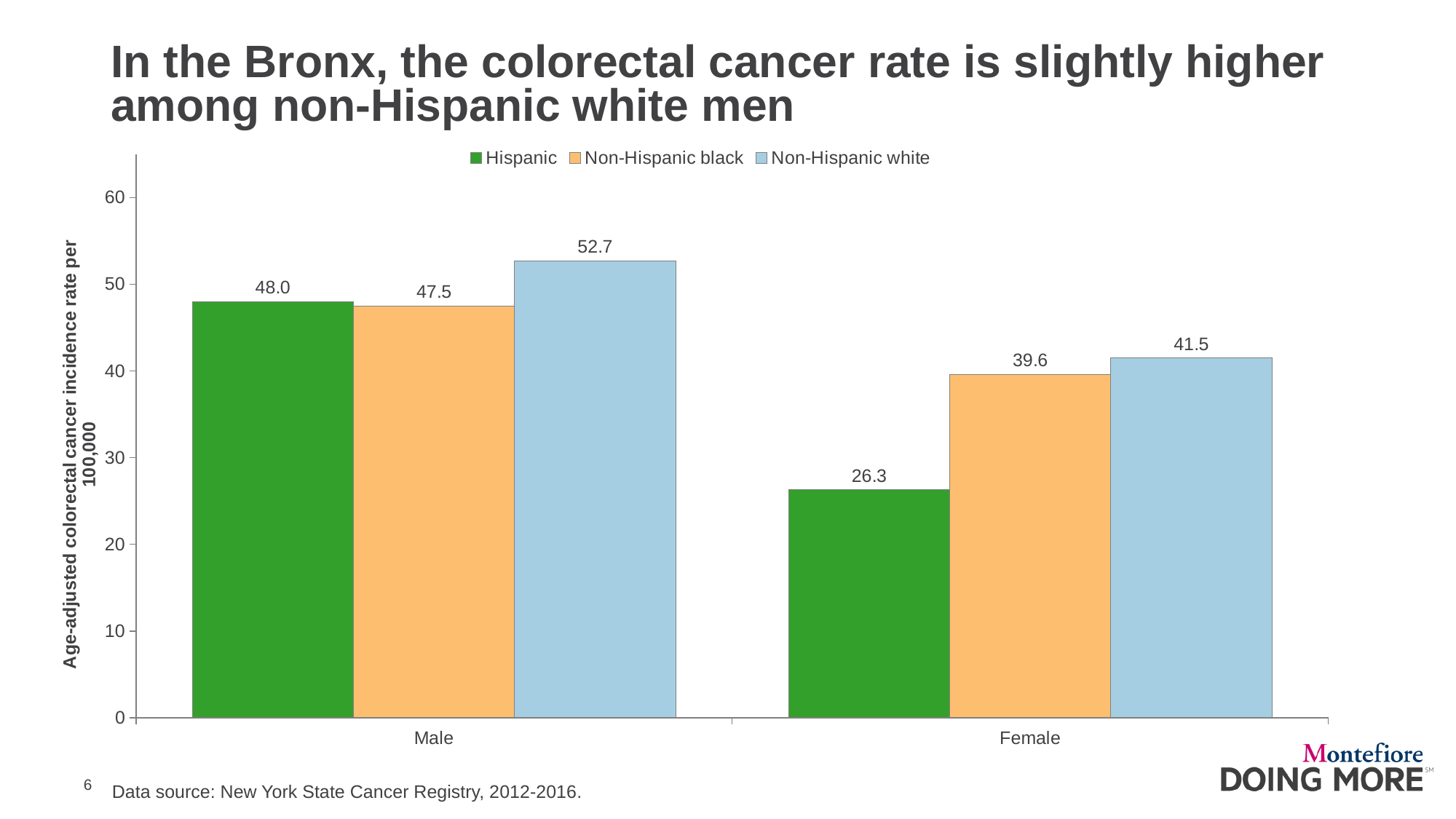
What is the colorectal cancer incidence rate for Non-Hispanic white females? 41.5 What colour represents the Non-Hispanic black series? Orange What kind of chart is shown on the slide? Bar chart What is the colorectal cancer incidence rate for Non-Hispanic black males? 47.5 Which group has the lowest colorectal cancer incidence rate among females? Hispanic Which is larger: the Hispanic male rate or the Hispanic female rate? Hispanic male rate What is the colorectal cancer incidence rate for Hispanic males? 48.0 Which group has the highest colorectal cancer incidence rate among males? Non-Hispanic white What is the difference between the Non-Hispanic white and Hispanic rates for females? 15.2 How many series does the legend list? 3 What is the difference between the Non-Hispanic white and Non-Hispanic black rates for males? 5.2 Is the value for Non-Hispanic black females greater or less than 30? greater